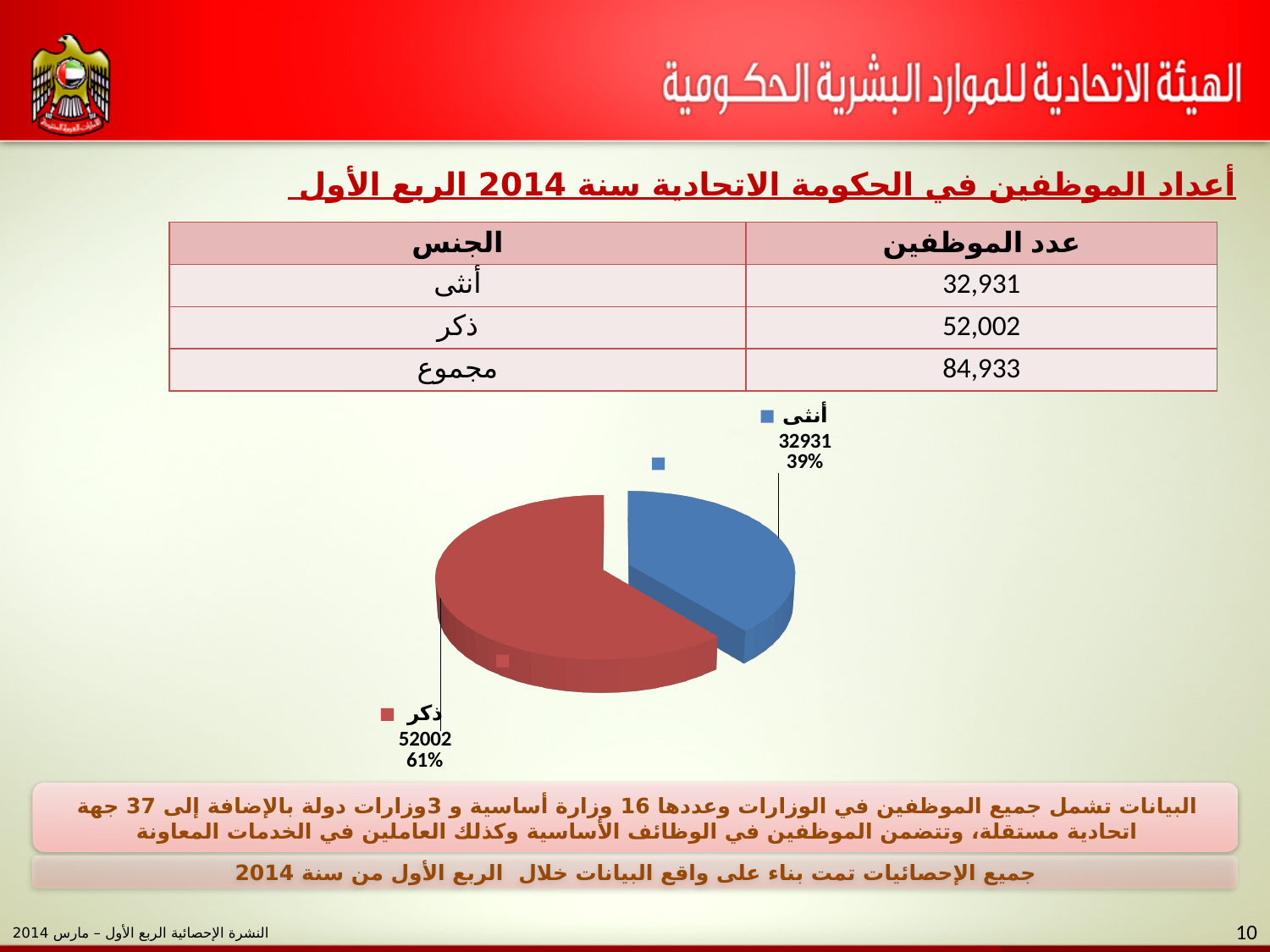
What percentage share of the pie does أنثى have? 39% What value is shown on the pie chart for أنثى? 32931 What kind of chart is shown on the slide? pie chart What percentage share of the pie does ذكر have? 61% What value is shown on the pie chart for ذكر? 52002 Which is larger in the pie chart, ذكر or أنثى? ذكر What is the total of the two values shown in the pie chart? 84933 How many slices does the pie chart have? 2 What is the difference between the values for ذكر and أنثى in the pie chart? 19071 Which slice of the pie chart is the largest? ذكر Which slice of the pie chart is the smallest? أنثى What colour is the ذكر slice in the pie chart? red